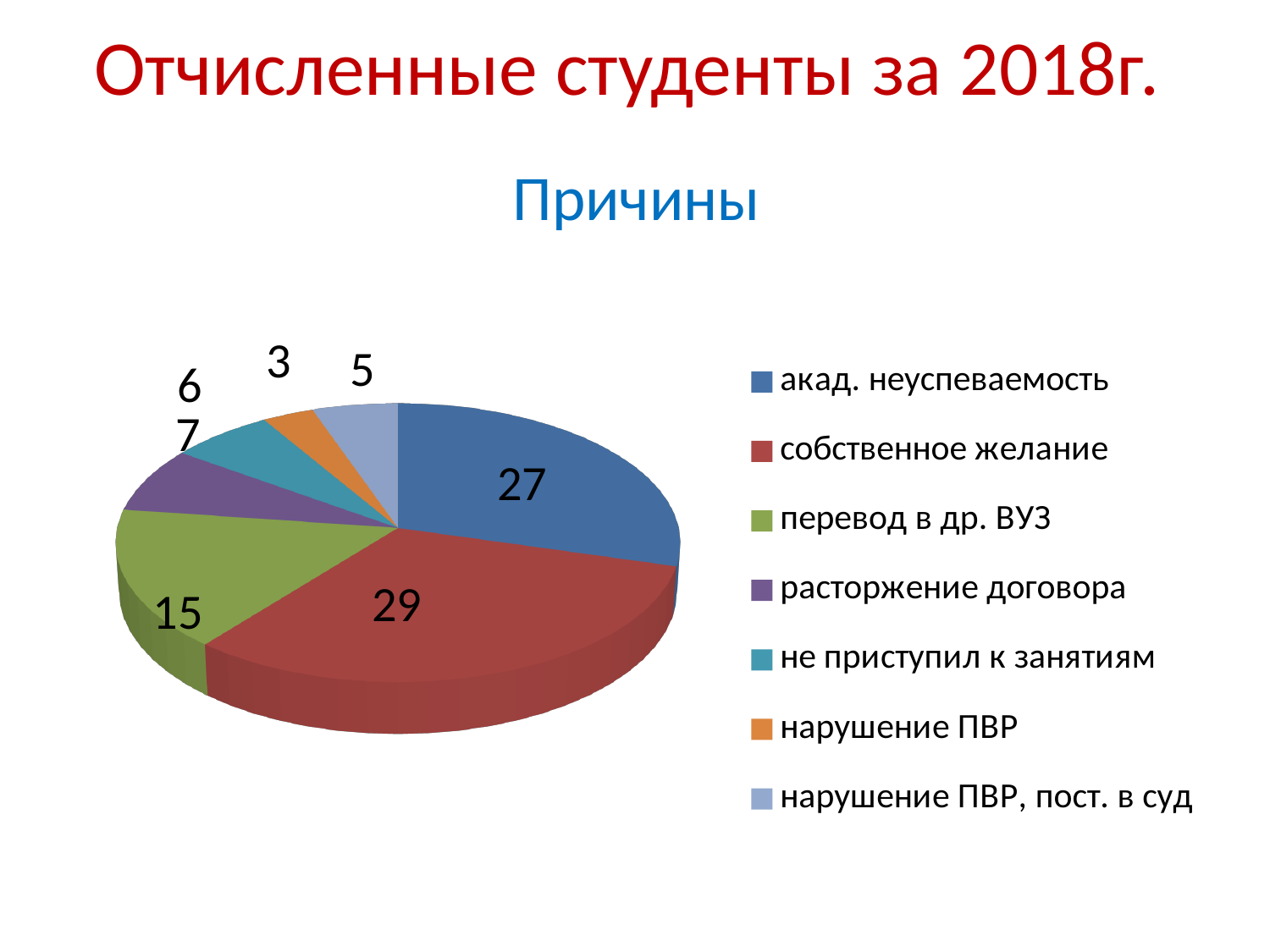
Which category has the largest slice? собственное желание Which is larger: расторжение договора or не приступил к занятиям? расторжение договора What type of chart is shown on the slide? pie chart What is the total of all slices in the pie chart? 92 How many categories does the pie chart have? 7 What is the value for собственное желание? 29 Which category has the smallest slice? нарушение ПВР What is the value for акад. неуспеваемость? 27 What is the difference between собственное желание and акад. неуспеваемость? 2 What is the value for перевод в др. ВУЗ? 15 What is the title of the chart? Причины What is the value for нарушение ПВР? 3